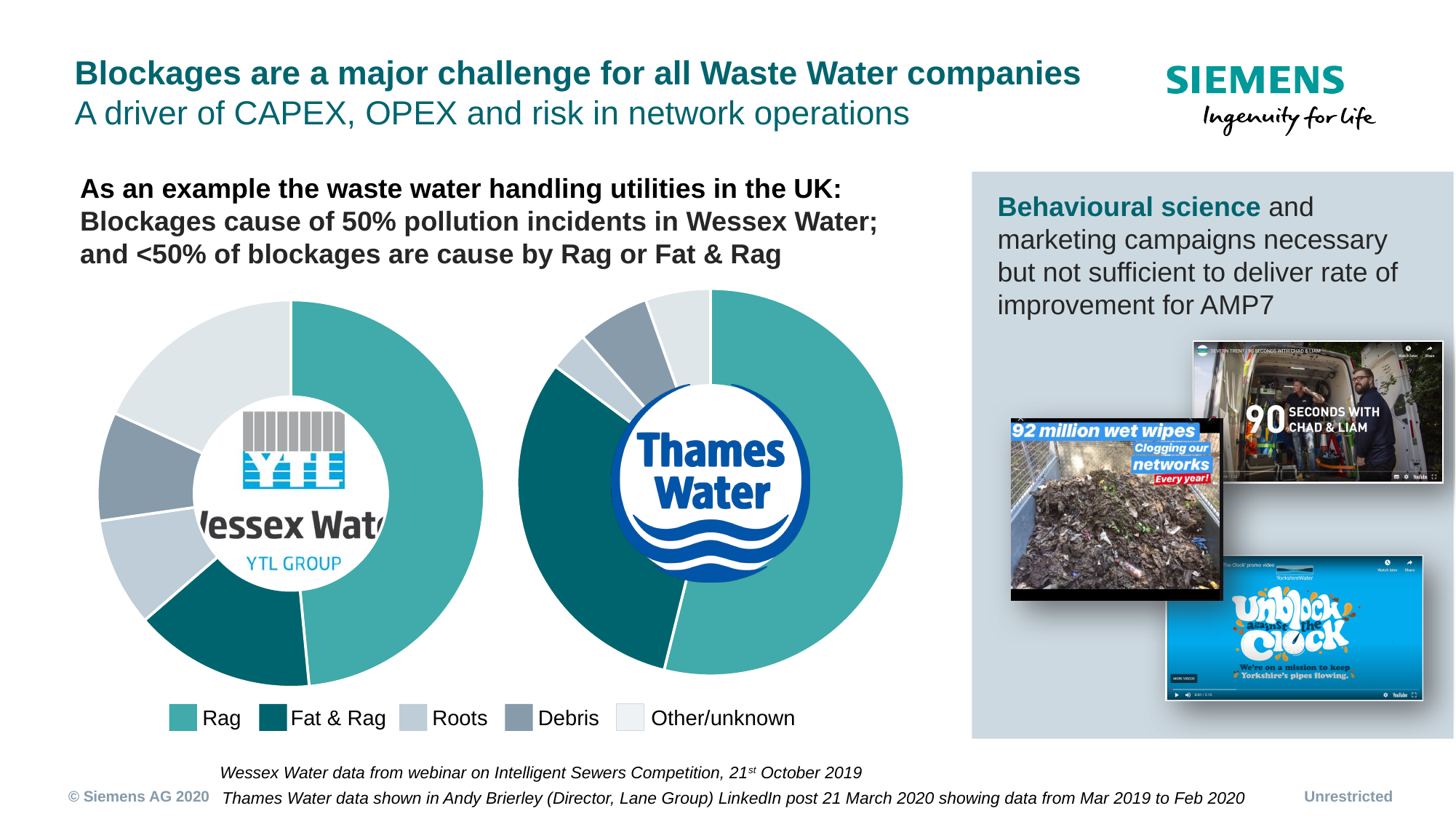
In the Wessex Water pie chart, which category has the largest share? Rag How many blockage-cause categories does the shared legend list for the two pie charts? 5 Which water company's pie chart is on the left of the slide? Wessex Water In the Thames Water pie chart, which category has the largest share? Rag What kind of chart is used to show the Wessex Water blockage causes? Pie (donut) chart In the Thames Water pie chart, which is larger: Rag or Fat & Rag? Rag In the Thames Water pie chart, which category has the smallest share? Roots How many slices does the Thames Water pie chart have? 5 In the Wessex Water pie chart, which is larger: Rag or Fat & Rag? Rag Which legend entry is shown in the darkest teal colour? Fat & Rag In the Thames Water pie chart, which is larger: Fat & Rag or Debris? Fat & Rag